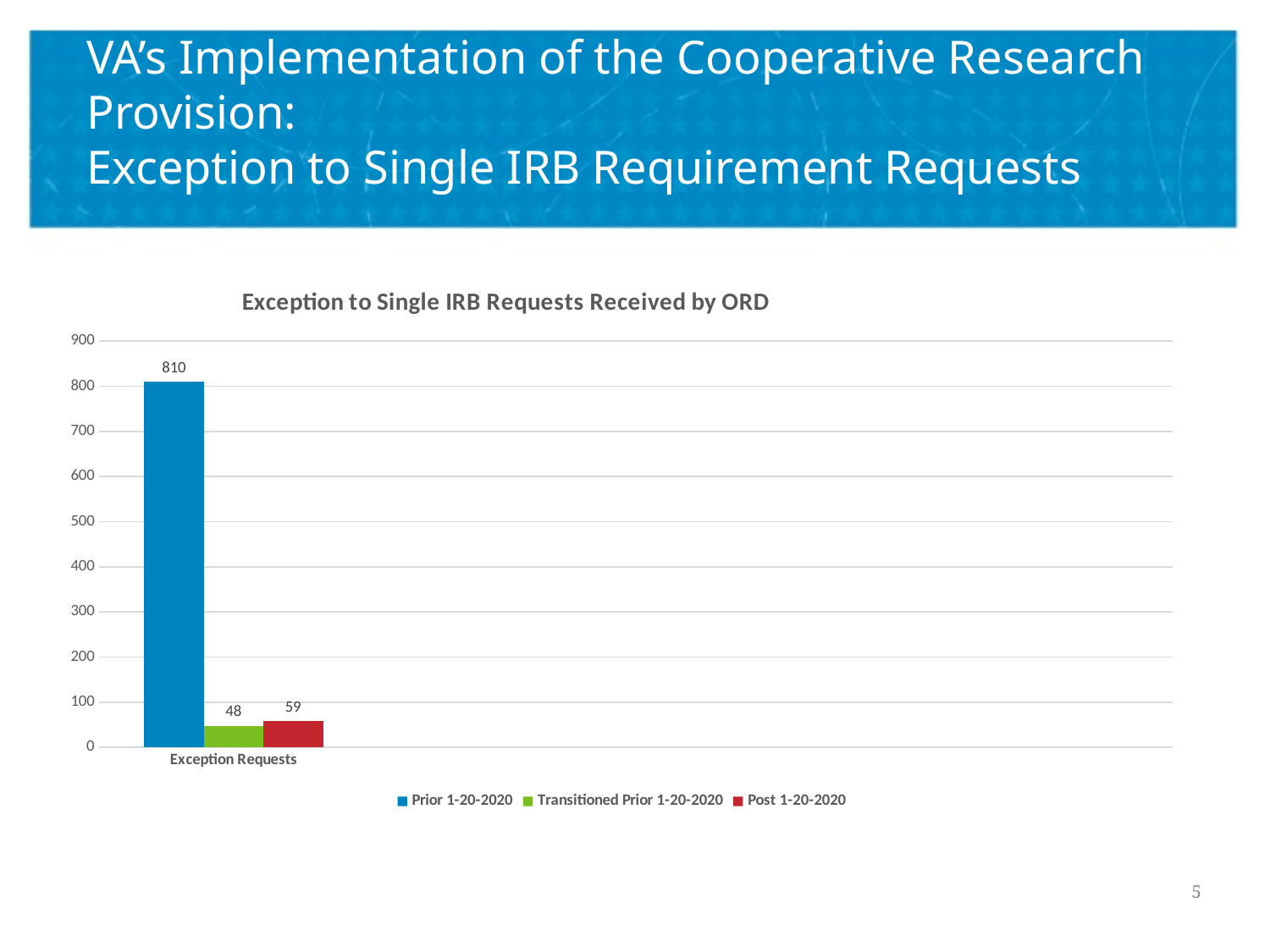
How many series does the legend list? 3 Is the value for Prior 1-20-2020 greater or less than 800? greater What is the title of the chart? Exception to Single IRB Requests Received by ORD What is the value for Transitioned Prior 1-20-2020? 48 What is the value for Post 1-20-2020? 59 Which series has the lowest value? Transitioned Prior 1-20-2020 What kind of chart is shown on the slide? bar chart What is the difference between the Post 1-20-2020 value and the Transitioned Prior 1-20-2020 value? 11 What is the difference between the Prior 1-20-2020 value and the Post 1-20-2020 value? 751 Which is larger, the value for Post 1-20-2020 or the value for Transitioned Prior 1-20-2020? Post 1-20-2020 Which series has the highest value? Prior 1-20-2020 What is the value for Prior 1-20-2020 in the Exception Requests category? 810